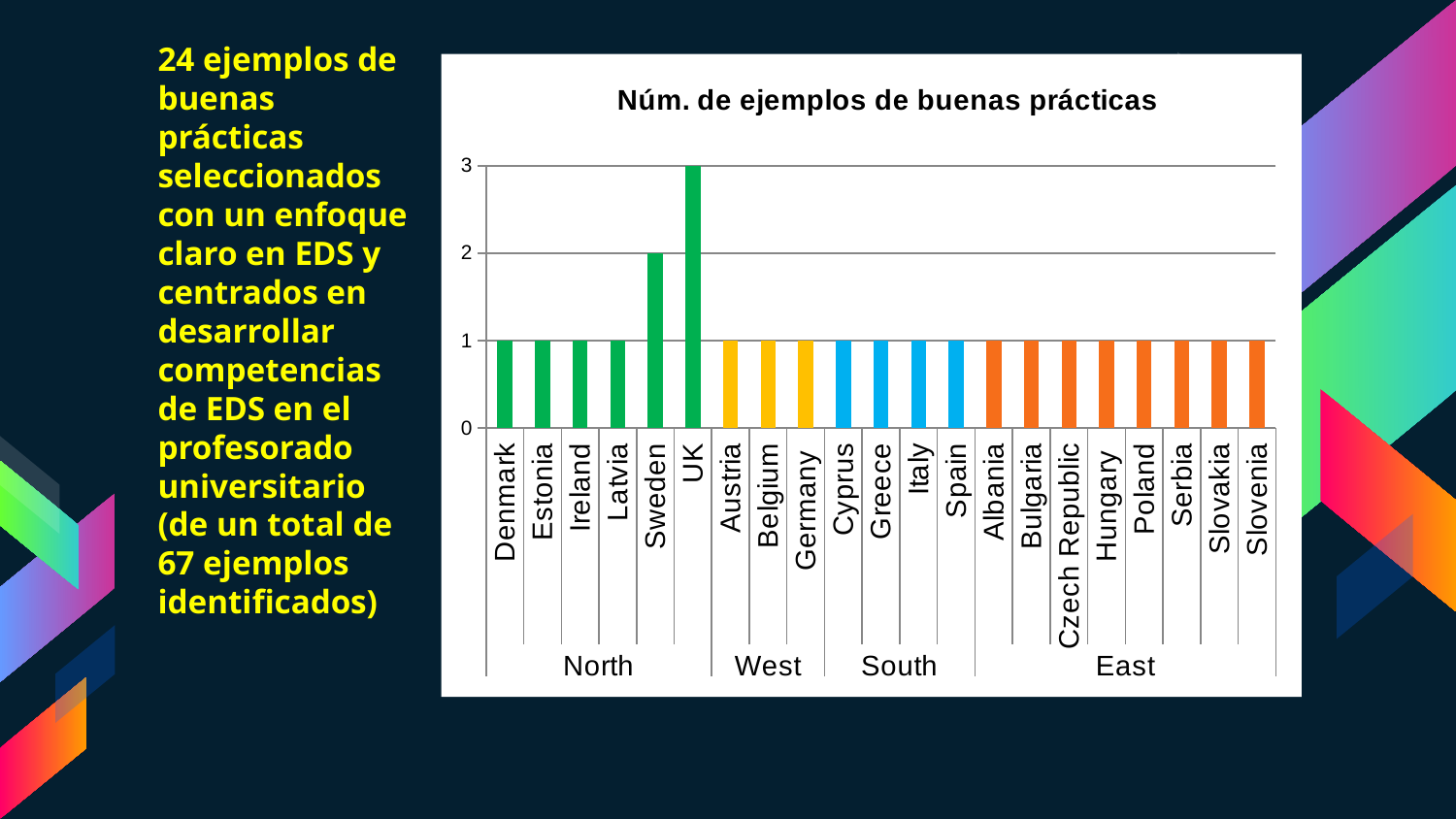
What is the value for Sweden in the chart? 2 Which country has the highest value in the chart? UK What is the value for Denmark in the chart? 1 How many countries are shown on the x axis of the chart? 21 Which has a larger value, Sweden or Austria? Sweden What kind of chart is shown on the slide? Bar chart What is the title of the chart? Núm. de ejemplos de buenas prácticas What is the difference between the values for UK and Sweden? 1 Is the value for UK greater or less than 2? greater How many countries are listed under the East group on the x axis? 8 What is the value for UK in the chart? 3 How many regional groups are labelled along the x axis? 4